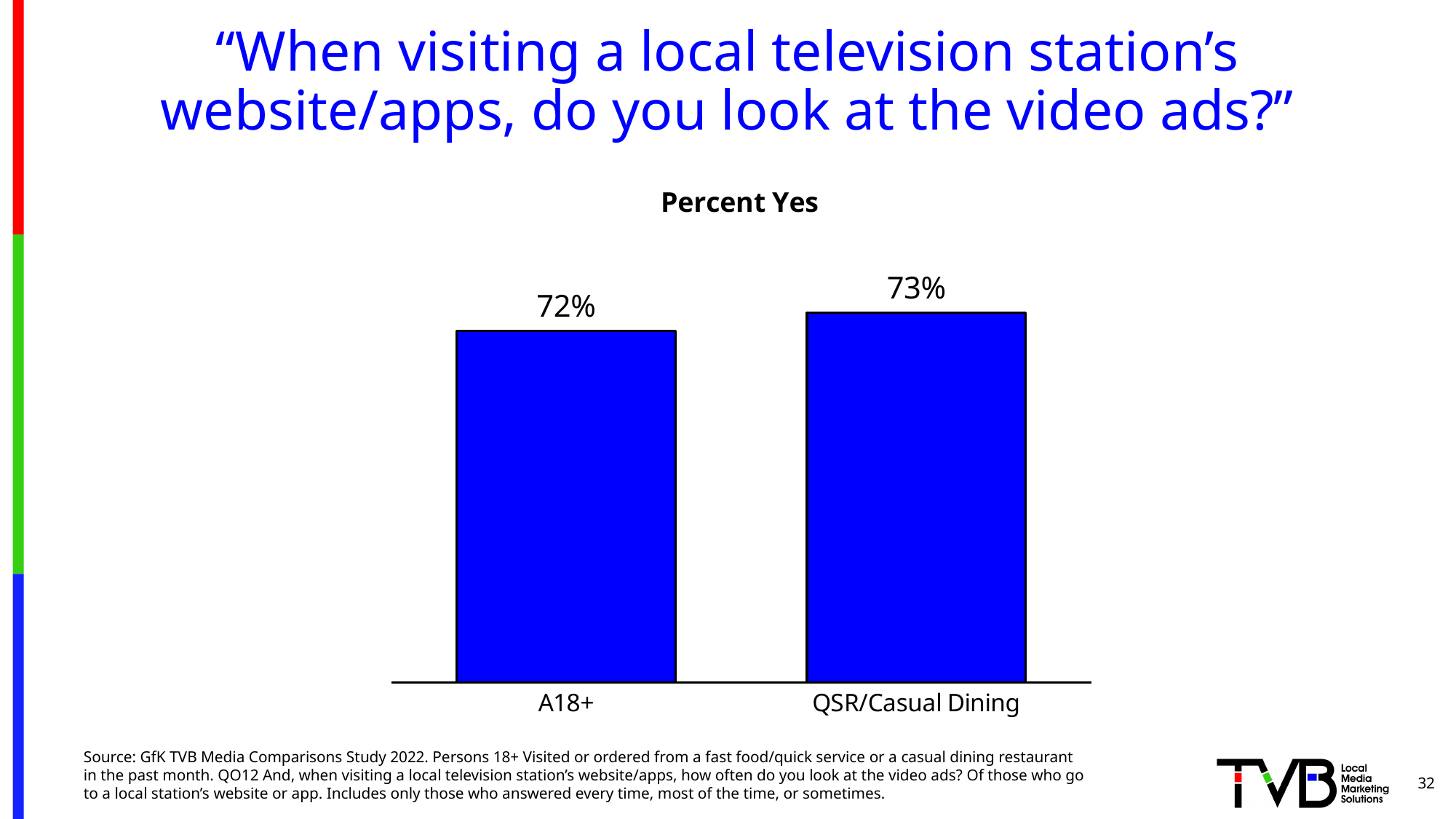
What is the difference between the QSR/Casual Dining value and the A18+ value? 1% What is the value for QSR/Casual Dining? 73% What is the title of the chart? Percent Yes What colour are the bars in the chart? blue What kind of chart is shown on the slide? bar chart How many categories are shown in the chart? 2 What is the value for A18+? 72% Which category has the lower value according to the data labels? A18+ Based on the data labels, is the value for QSR/Casual Dining larger or smaller than the value for A18+? larger Which category has the higher value according to the data labels? QSR/Casual Dining